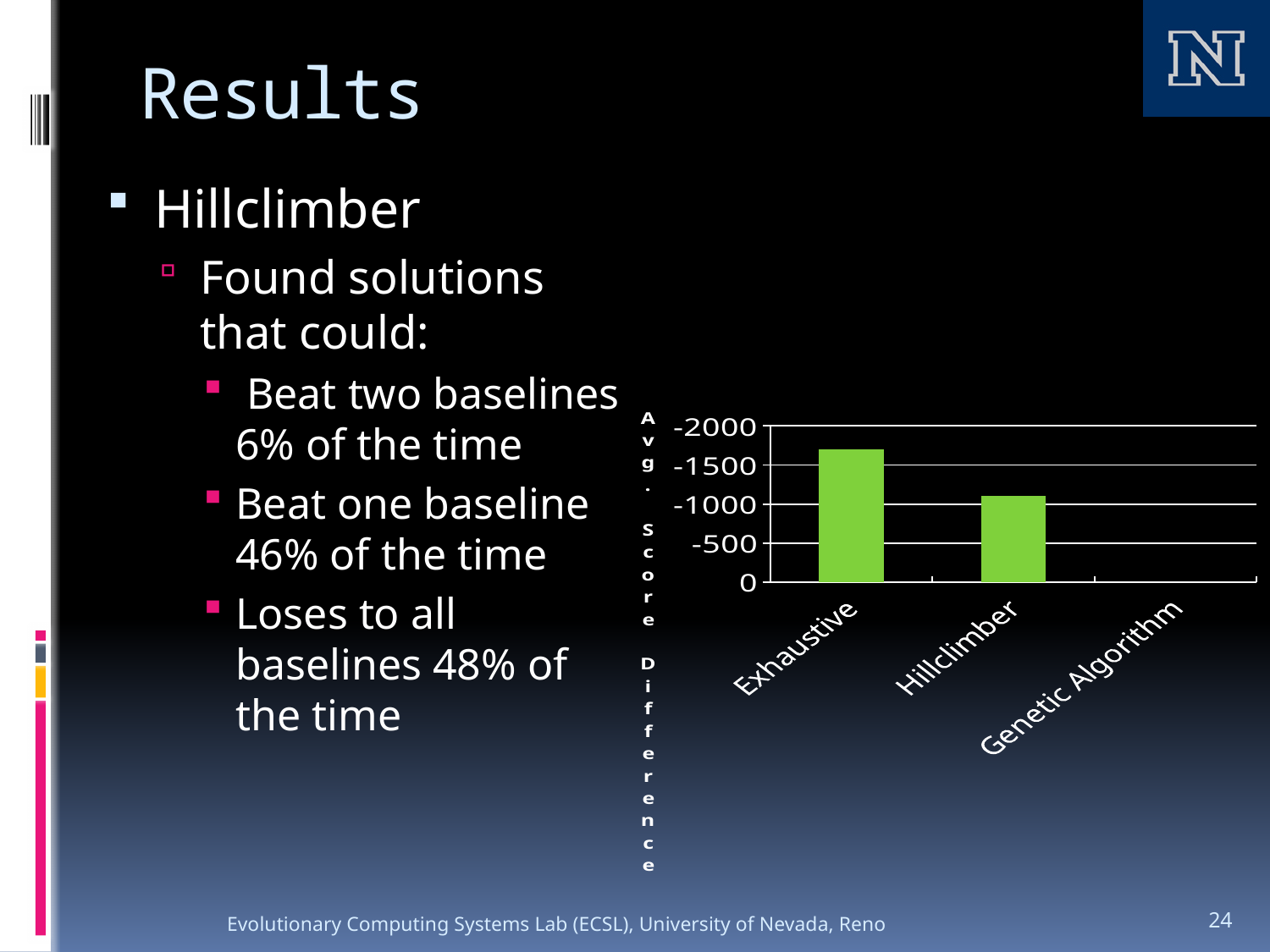
What is the label of the third category on the x axis? Genetic Algorithm Is the value for Hillclimber greater or less than -1000? less Do the bars get taller or shorter moving from left to right along the x axis? shorter Is the value for Exhaustive greater or less than -1500? less Which category has the tallest bar in the chart? Exhaustive What is the label of the vertical axis of the chart? Avg. Score Difference Which category has the most negative Avg. Score Difference? Exhaustive Which bar is taller, Exhaustive or Hillclimber? Exhaustive How many categories are shown on the x axis of the chart? 3 What kind of chart is shown on the slide? bar chart Is the value for Hillclimber greater or less than -1500? greater